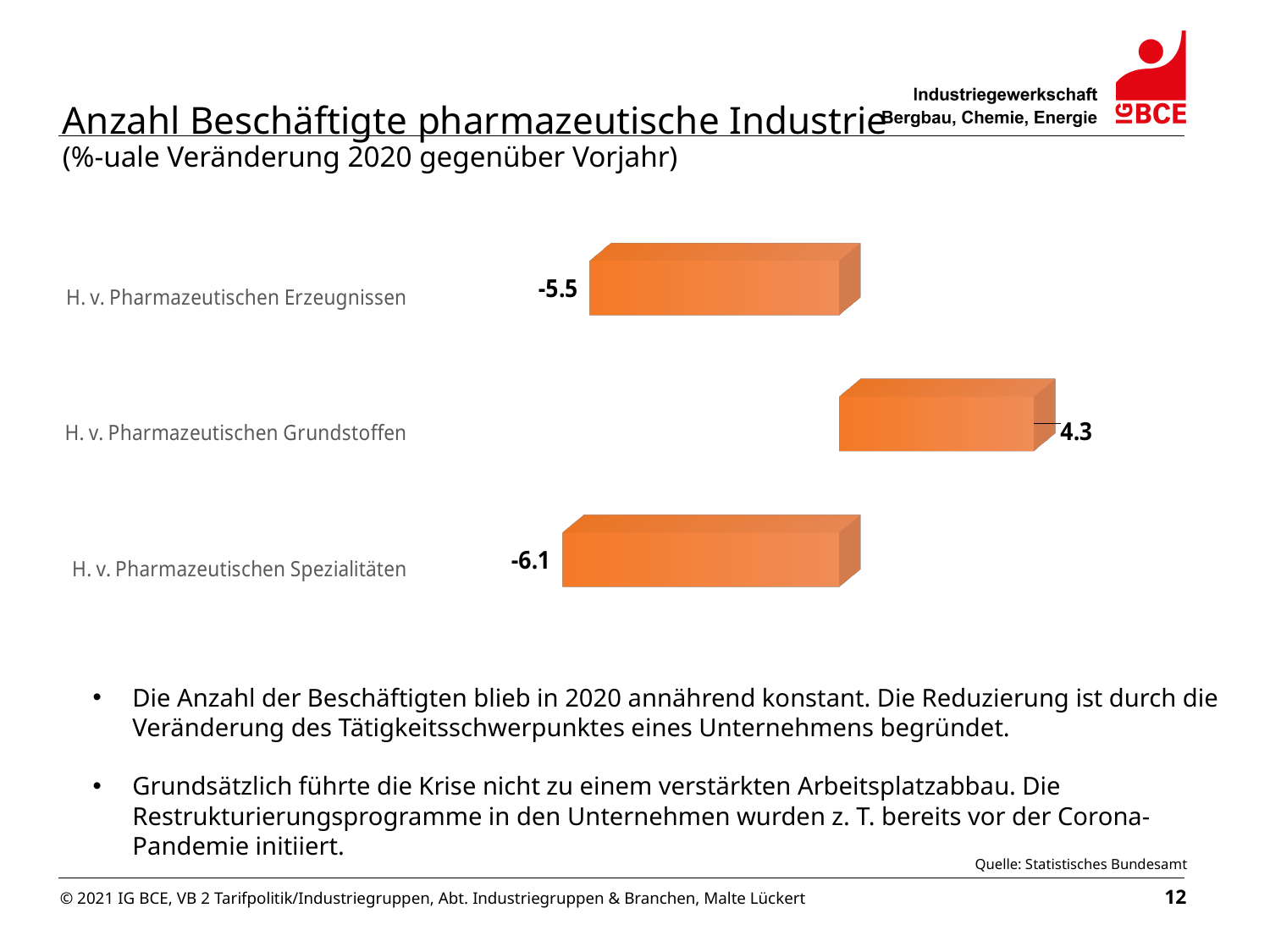
How many categories have a negative value? 2 What is the value for H. v. Pharmazeutischen Spezialitäten? -6.1 What is the difference between the values for H. v. Pharmazeutischen Erzeugnissen and H. v. Pharmazeutischen Spezialitäten? 0.6 Which category has the highest value? H. v. Pharmazeutischen Grundstoffen What is the value for H. v. Pharmazeutischen Grundstoffen? 4.3 What is the difference between the values for H. v. Pharmazeutischen Grundstoffen and H. v. Pharmazeutischen Erzeugnissen? 9.8 Which category has the lowest value? H. v. Pharmazeutischen Spezialitäten What is the title of the chart on the slide? Anzahl Beschäftigte pharmazeutische Industrie What kind of chart is shown on the slide? Bar chart Which is larger, the value for H. v. Pharmazeutischen Erzeugnissen or for H. v. Pharmazeutischen Spezialitäten? H. v. Pharmazeutischen Erzeugnissen What is the value for H. v. Pharmazeutischen Erzeugnissen? -5.5 How many categories are shown in the chart? 3